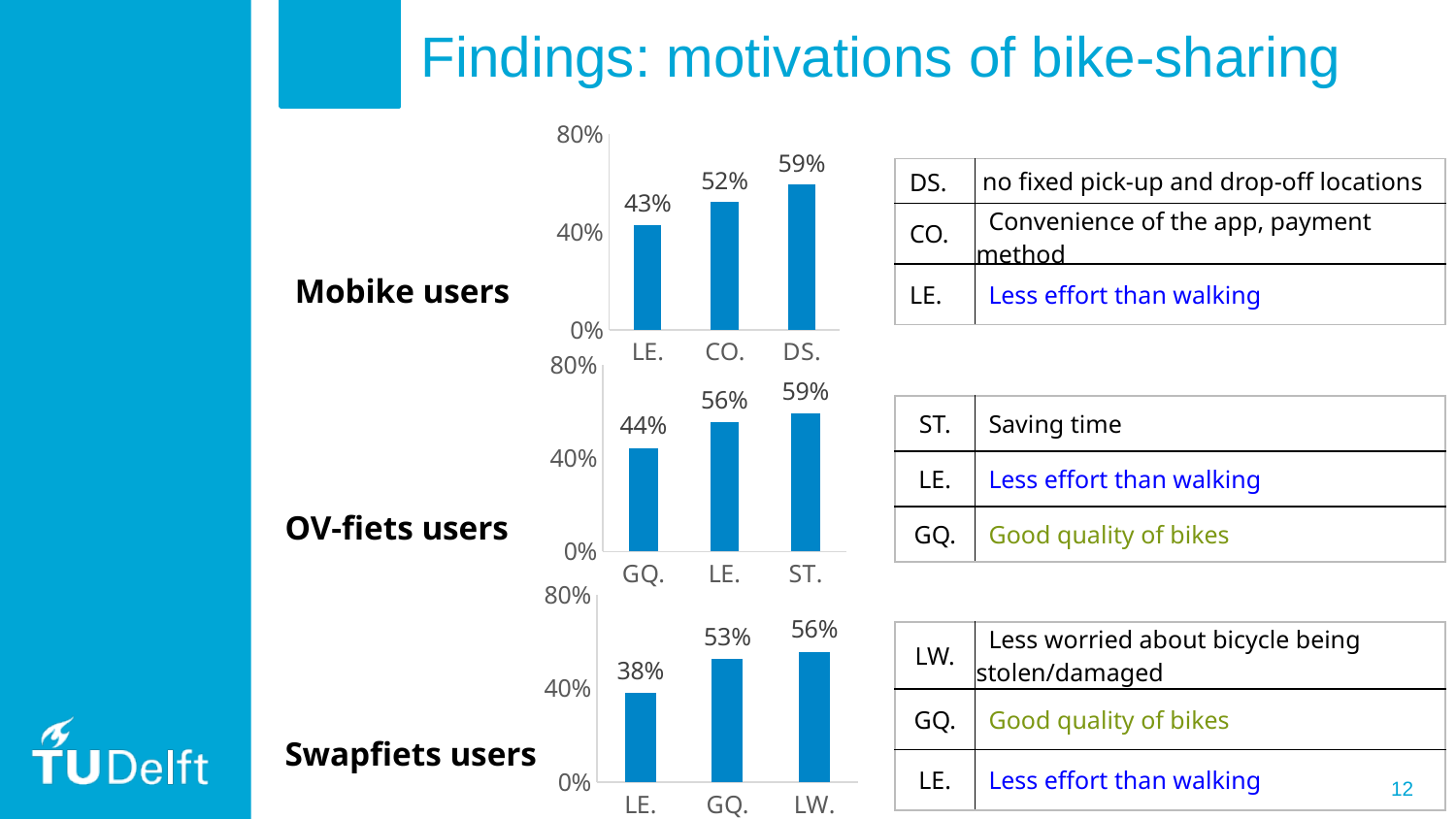
In the Swapfiets users chart, what is the difference between the values for GQ. and LE.? 15% How many categories are shown in the Swapfiets users chart? 3 In the Swapfiets users chart, which category has the lowest value? LE. In the Swapfiets users chart, what is the value for LW.? 56% In the OV-fiets users chart, which category has the highest value? ST. In the Mobike users chart, what is the value for DS.? 59% In the OV-fiets users chart, which is larger, the value for LE. or the value for GQ.? LE. In the Mobike users chart, what is the difference between the values for DS. and LE.? 16% In the Mobike users chart, what is the value for LE.? 43% In the Mobike users chart, is the value for CO. greater or less than 40%? greater What type of chart is the OV-fiets users chart? bar chart In the OV-fiets users chart, what is the value for GQ.? 44%